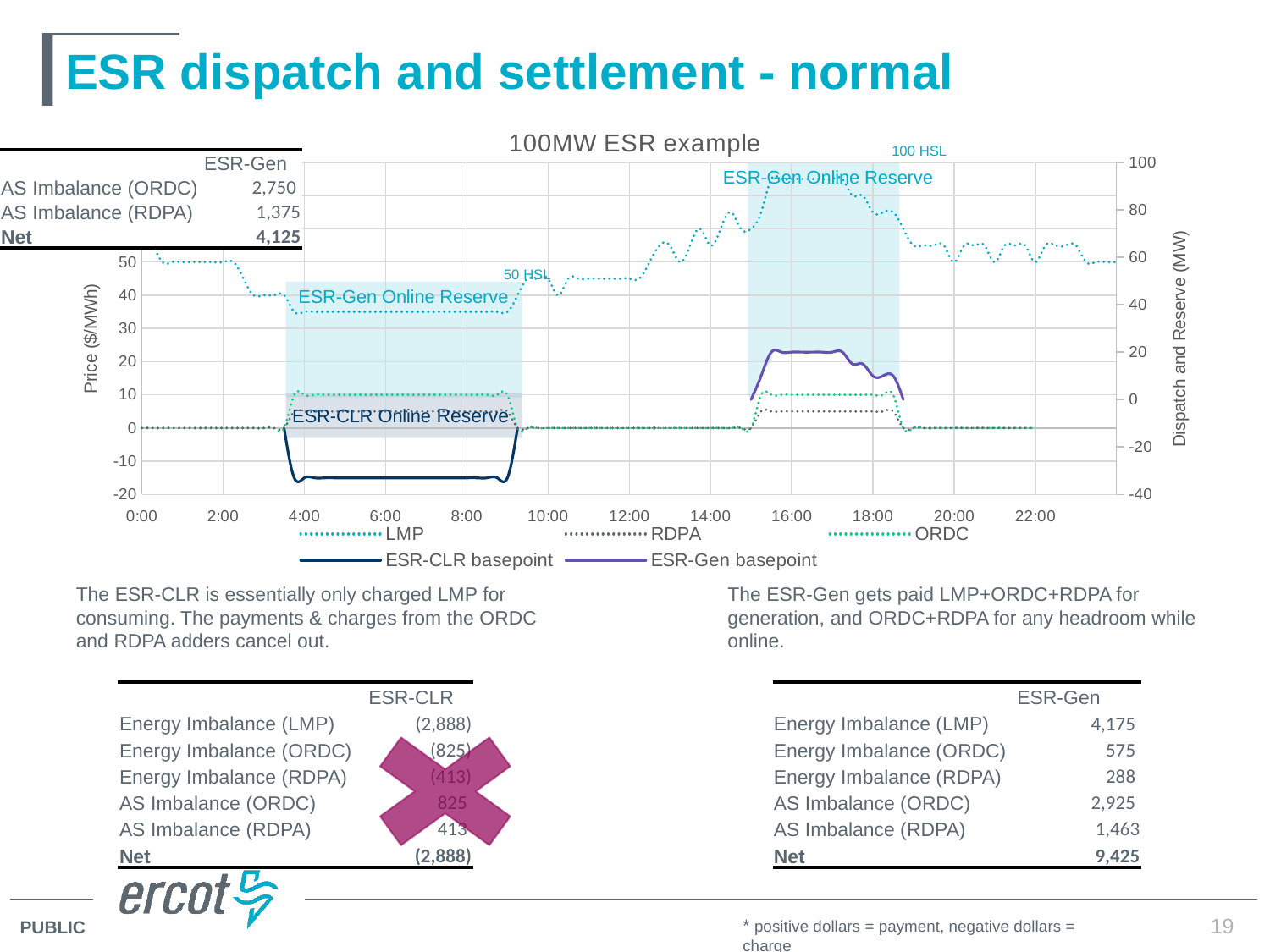
Between 15:00 and 19:00, is the ESR-Gen basepoint line above or below zero? above Which series has the highest value at around 17:00? LMP Does the LMP line rise or fall between 10:00 and 17:00? rise How many time labels are shown on the x axis of the chart? 12 How many series does the legend of the "100MW ESR example" chart list? 5 What kind of chart is the "100MW ESR example" chart? line chart Which series are listed in the legend of the chart? LMP, RDPA, ORDC, ESR-CLR basepoint, ESR-Gen basepoint At around 17:00, which is larger: the LMP line or the ESR-Gen basepoint line? LMP What is the title of the chart on the slide? 100MW ESR example Is the LMP value at 0:00 greater or less than 40 $/MWh on the left axis? greater Between 4:00 and 9:00, is the ESR-CLR basepoint line above or below zero? below